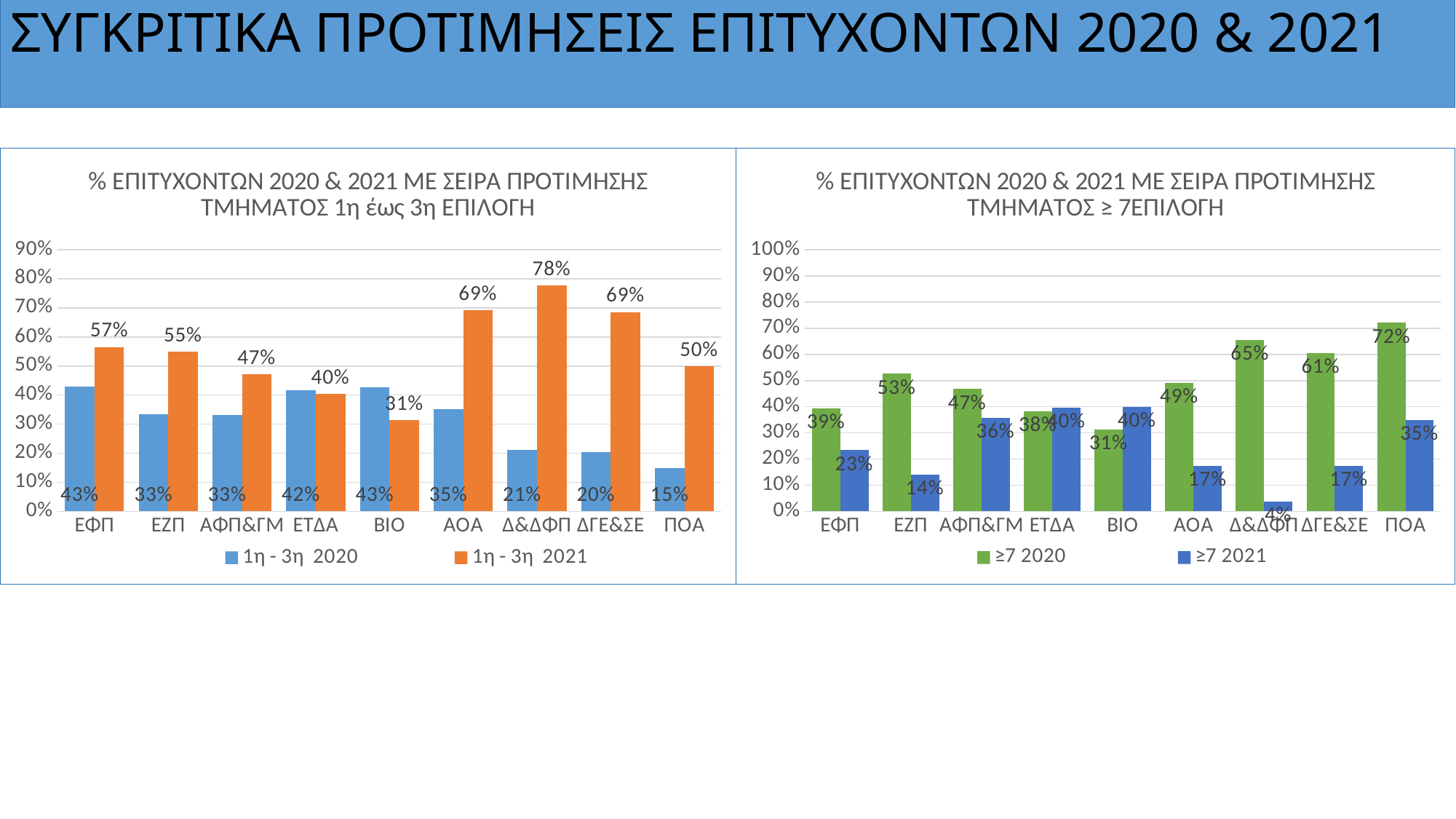
In the right chart (≥ 7ΕΠΙΛΟΓΗ), what is the value for ΠΟΑ in the ≥7 2020 series? 72% In the left chart (1η έως 3η ΕΠΙΛΟΓΗ), which is larger for ΒΙΟ: the 1η - 3η 2020 value or the 1η - 3η 2021 value? 1η - 3η 2020 In the left chart (1η έως 3η ΕΠΙΛΟΓΗ), what is the difference between the 2021 and 2020 values for ΑΟΑ? 34% In the left chart (1η έως 3η ΕΠΙΛΟΓΗ), what is the value for ΠΟΑ in the 1η - 3η 2020 series? 15% In the right chart (≥ 7ΕΠΙΛΟΓΗ), what is the difference between the ≥7 2020 and ≥7 2021 values for ΕΖΠ? 39% In the left chart (1η έως 3η ΕΠΙΛΟΓΗ), which category has the highest value in the 1η - 3η 2021 series? Δ&ΔΦΠ In the right chart (≥ 7ΕΠΙΛΟΓΗ), which category has the lowest value in the ≥7 2021 series? Δ&ΔΦΠ In the left chart (1η έως 3η ΕΠΙΛΟΓΗ), what is the value for Δ&ΔΦΠ in the 1η - 3η 2021 series? 78% What type of chart is the left chart (1η έως 3η ΕΠΙΛΟΓΗ)? Bar chart In the left chart (1η έως 3η ΕΠΙΛΟΓΗ), which category has the lowest value in the 1η - 3η 2020 series? ΠΟΑ How many categories are shown on the x axis of the right chart (≥ 7ΕΠΙΛΟΓΗ)? 9 In the right chart (≥ 7ΕΠΙΛΟΓΗ), what is the value for Δ&ΔΦΠ in the ≥7 2021 series? 4%